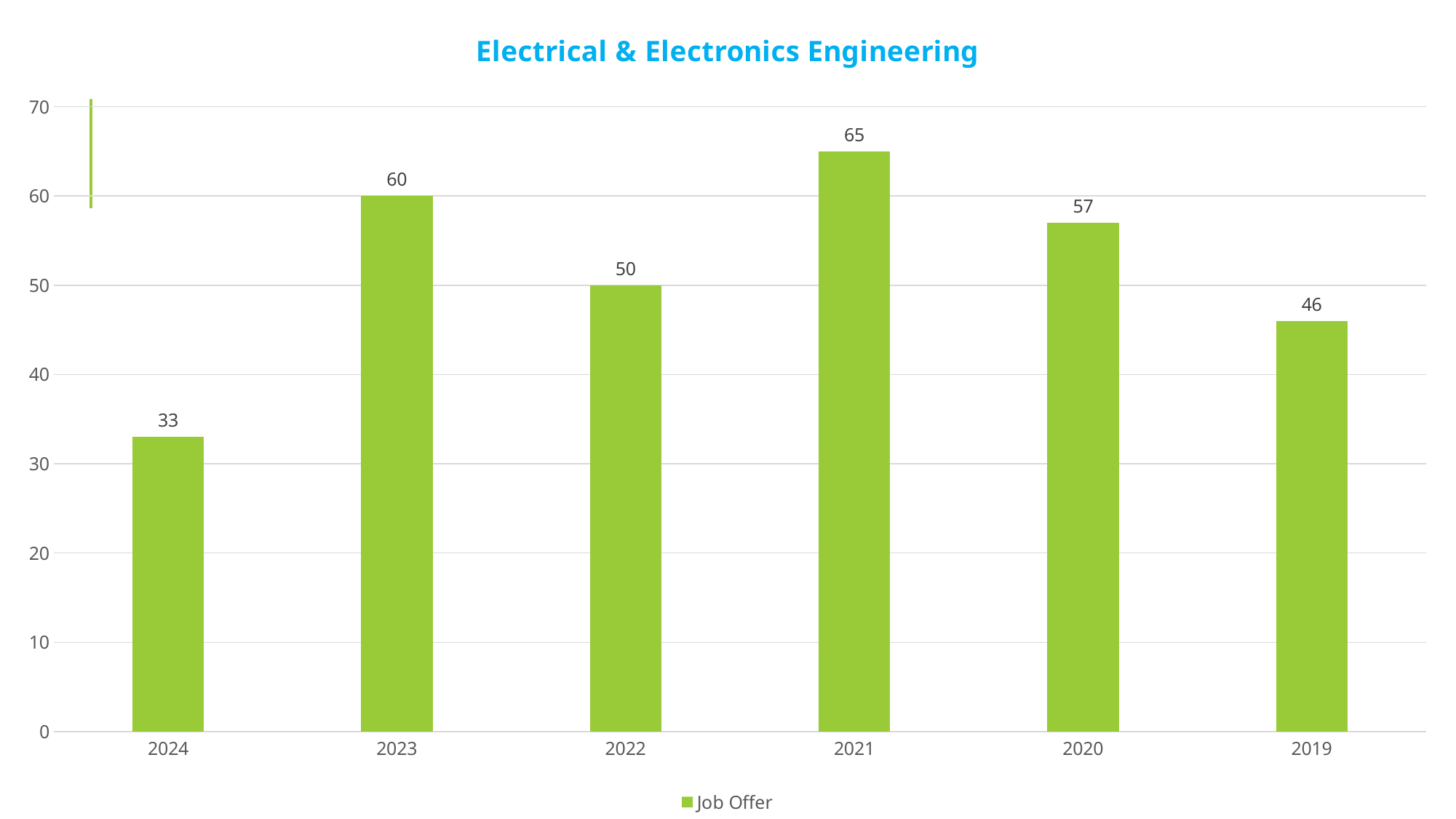
What is the Job Offer value for 2019? 46 How many years are shown on the x axis? 6 Which year has the highest Job Offer value? 2021 What is the difference between the Job Offer values for 2021 and 2024? 32 What kind of chart is shown on the slide? Bar chart What is the difference between the Job Offer values for 2023 and 2022? 10 Which year has the lowest Job Offer value? 2024 What is the Job Offer value for 2024? 33 What is the Job Offer value for 2021? 65 Which year has a larger Job Offer value, 2020 or 2019? 2020 Is the Job Offer value for 2022 greater or less than 40? greater How many series does the legend list? 1